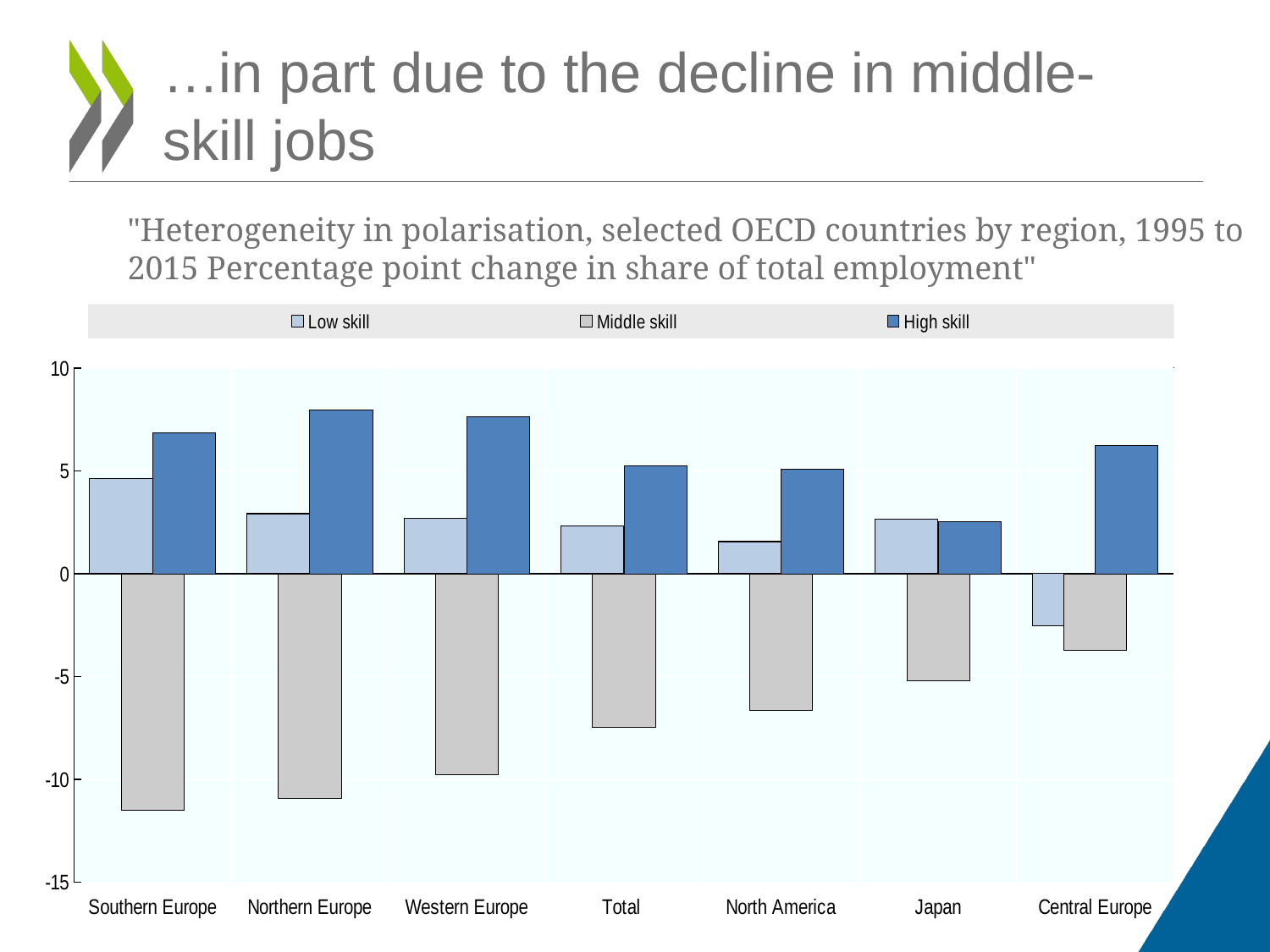
Is the Middle skill value for Total greater or less than -5? less Which is larger, the High skill value for Southern Europe or for Japan? Southern Europe Is the High skill value for Northern Europe greater or less than 5? greater How many series does the legend list? 3 Which region has the highest Low skill value? Southern Europe What kind of chart is shown on the slide? bar chart How many regions (categories) are shown on the x axis? 7 Which region has the highest (least negative) Middle skill value? Central Europe Which region has the lowest Low skill value? Central Europe Is the Middle skill value for Southern Europe greater or less than -10? less Which is the only region with a negative Low skill value? Central Europe